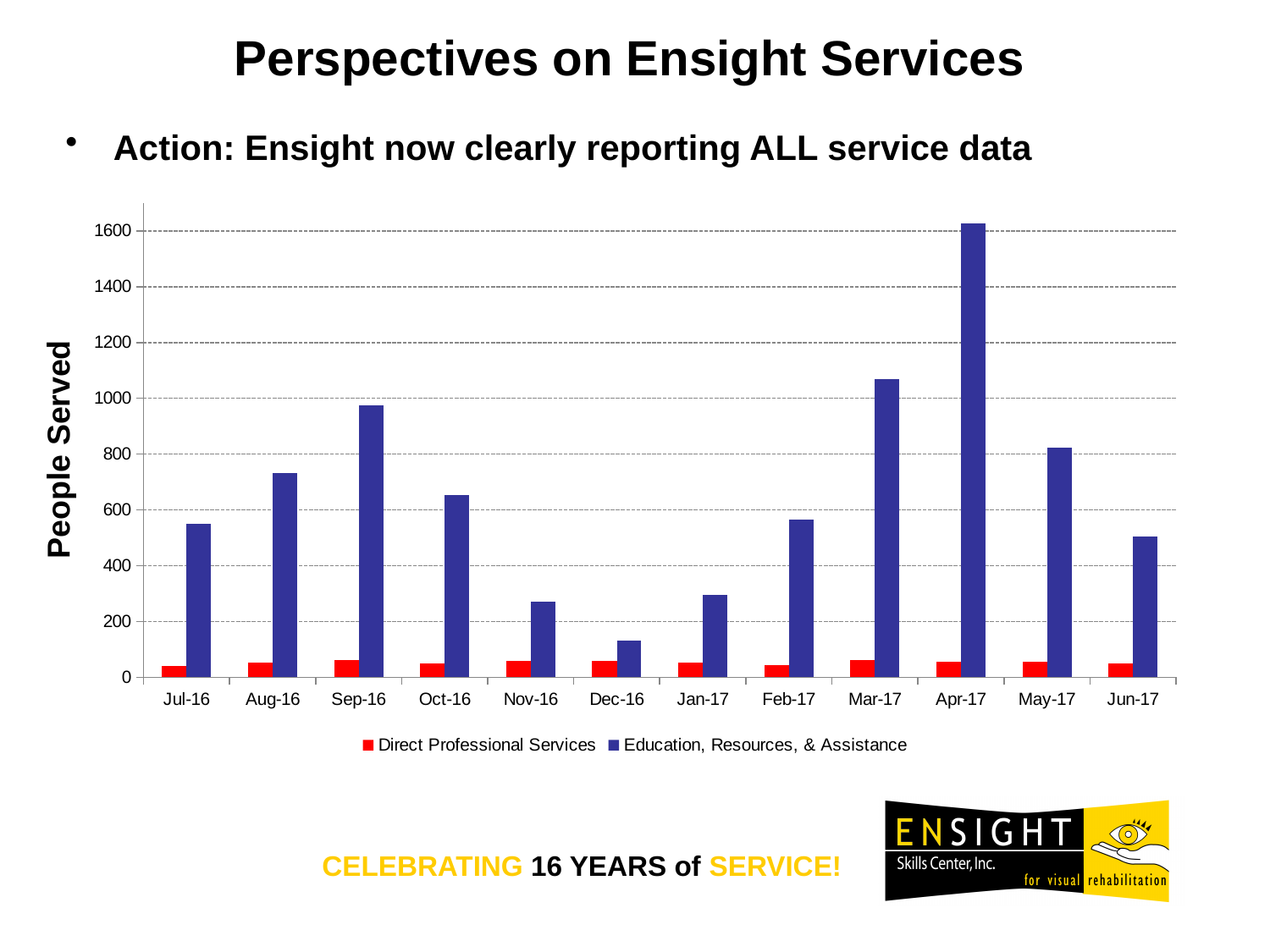
How many months are shown along the x axis of the chart? 12 Which month has the larger Education, Resources, & Assistance value, Mar-17 or May-17? Mar-17 What is the title of the vertical axis of the chart? People Served Is the Education, Resources, & Assistance value for Apr-17 greater or less than 1400? greater In which month is the Education, Resources, & Assistance value lowest? Dec-16 How many series does the chart legend list? 2 In which month is the Education, Resources, & Assistance value highest? Apr-17 Is the Education, Resources, & Assistance value for Mar-17 greater or less than 1000? greater Which month has the larger Education, Resources, & Assistance value, Sep-16 or Oct-16? Sep-16 Is the Education, Resources, & Assistance value for Aug-16 greater or less than 600? greater What kind of chart is shown on the slide? bar chart